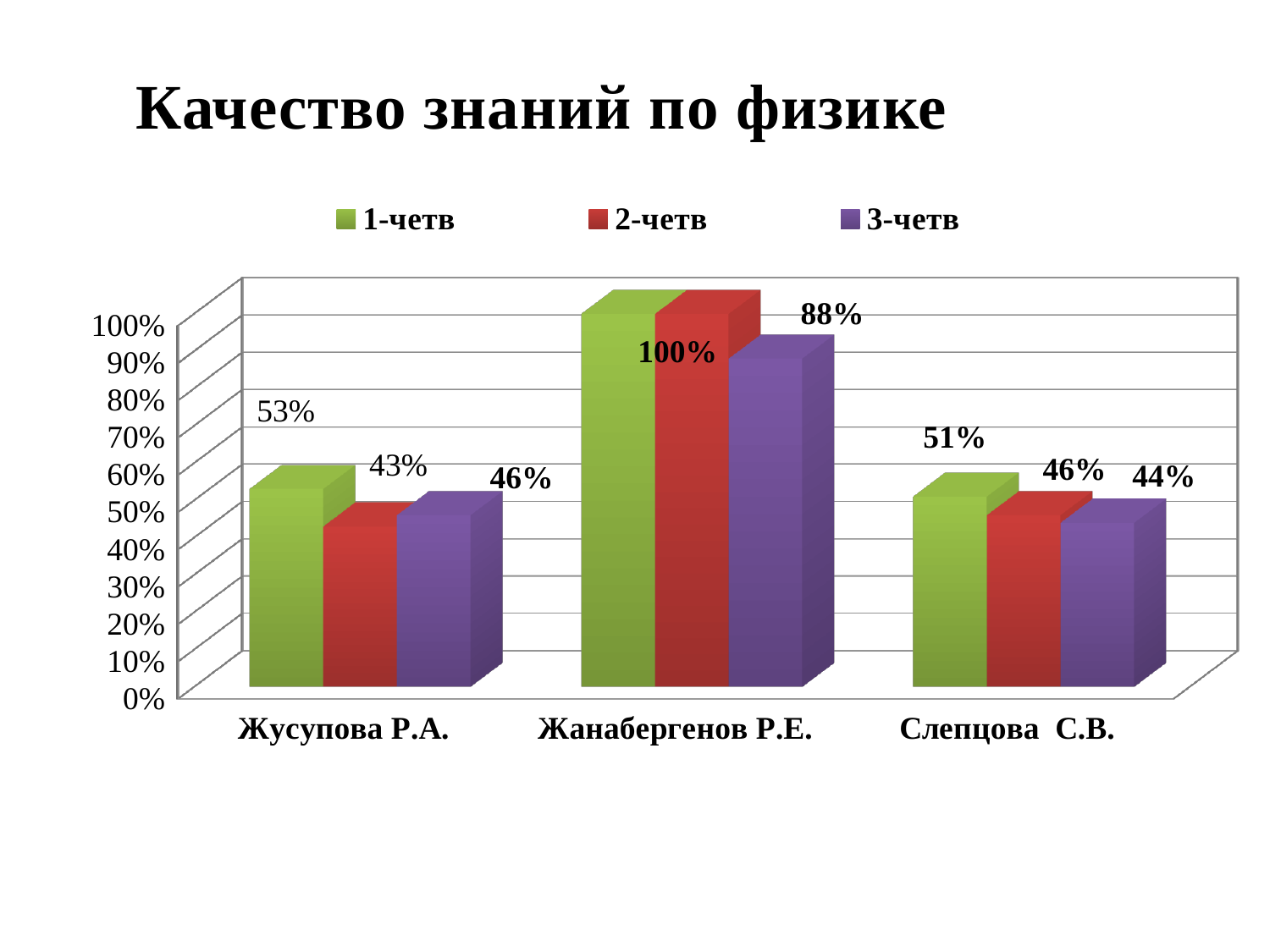
What is the value for Жусупова Р.А. in the 1-четв series? 53% What type of chart is shown on the slide? Bar chart How many series does the legend list? 3 Which category has the lowest value in the 2-четв series? Жусупова Р.А. Which is larger in the 3-четв series: Жусупова Р.А. or Слепцова С.В.? Жусупова Р.А. What is the value for Жусупова Р.А. in the 2-четв series? 43% What is the value for Слепцова С.В. in the 3-четв series? 44% What is the value for Слепцова С.В. in the 1-четв series? 51% Which category has the highest value in the 3-четв series? Жанабергенов Р.Е. What is the value for Жанабергенов Р.Е. in the 3-четв series? 88% How many categories are shown on the x axis? 3 What is the difference between the 1-четв and 3-четв values for Слепцова С.В.? 7%